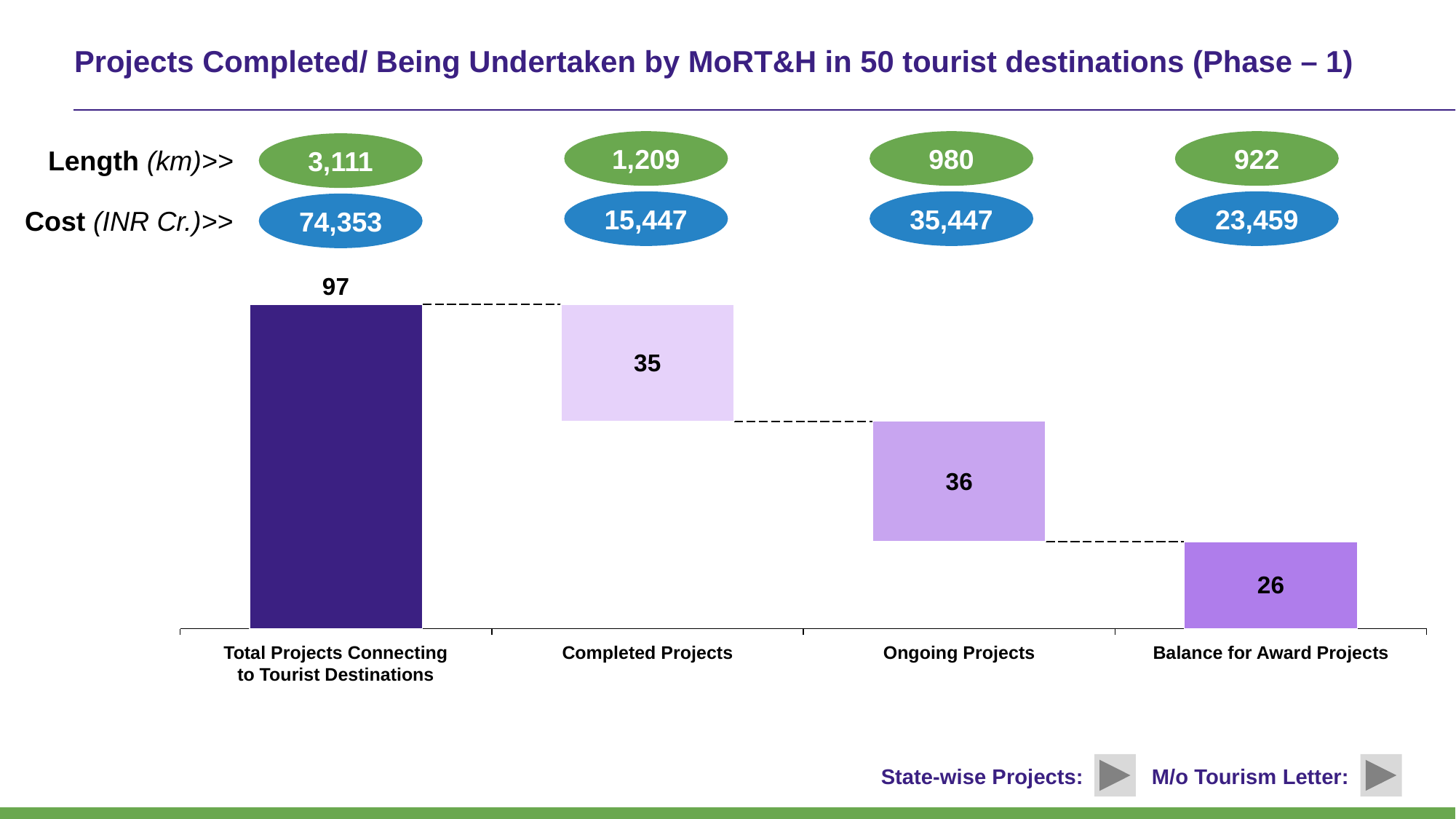
What is the difference between Total Projects Connecting to Tourist Destinations and Completed Projects? 62 Which category has the lowest value? Balance for Award Projects What is the title of the slide? Projects Completed/ Being Undertaken by MoRT&H in 50 tourist destinations (Phase – 1) What is the value for Completed Projects? 35 What is the value for Ongoing Projects? 36 What is the difference between Ongoing Projects and Balance for Award Projects? 10 Which is larger, Ongoing Projects or Balance for Award Projects? Ongoing Projects How many categories are shown on the x axis? 4 Which category has the highest value? Total Projects Connecting to Tourist Destinations What is the value for Balance for Award Projects? 26 What kind of chart is this? bar chart What is the value for Total Projects Connecting to Tourist Destinations? 97